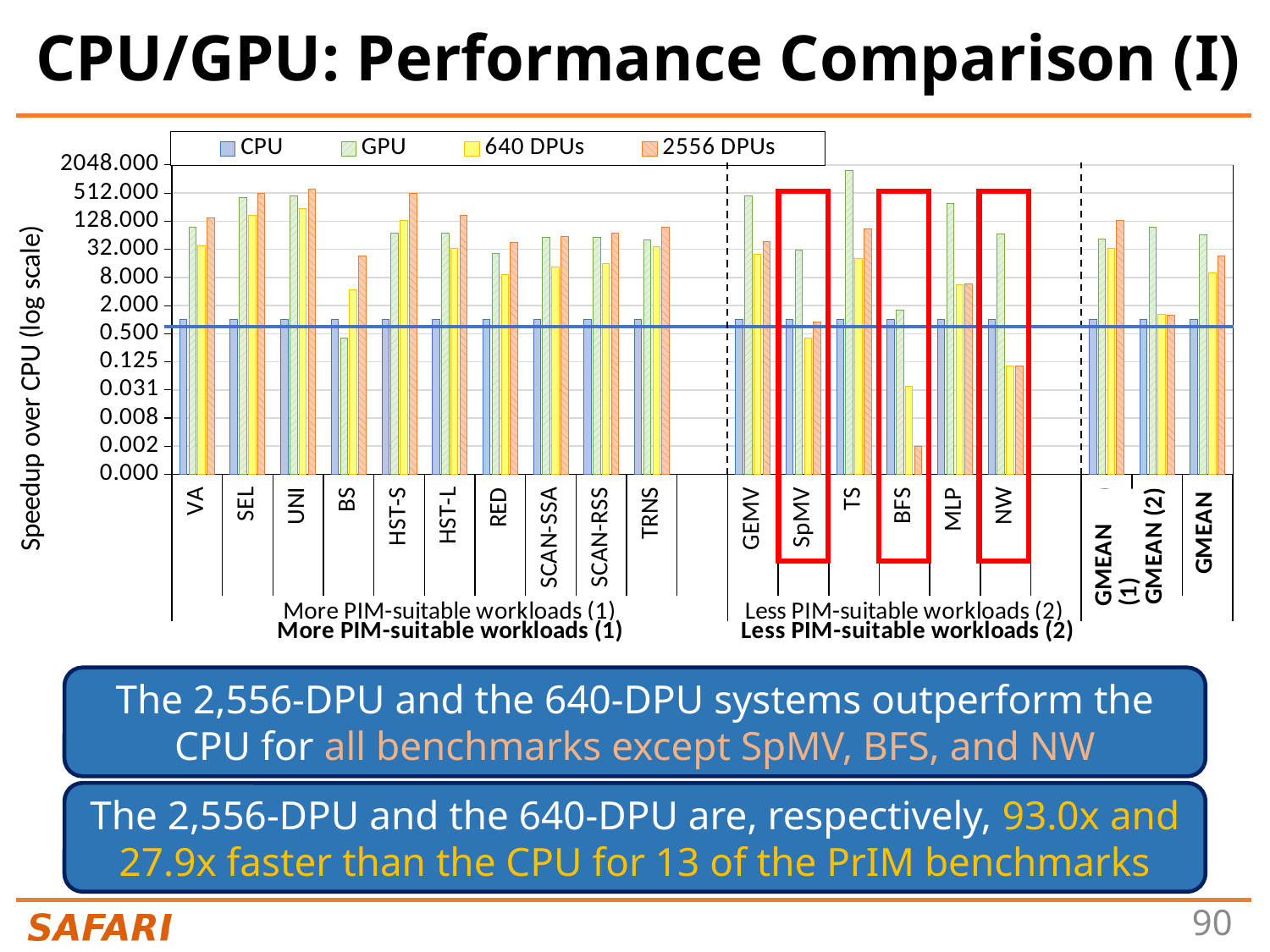
What is the label of the y axis? Speedup over CPU (log scale) How many series does the chart legend list? 4 Is the GPU value for TS greater or less than 512.000? greater Is the 2556 DPUs value for BFS greater or less than 0.008? less Is the 640 DPUs value for NW greater or less than 0.500? less What kind of chart is shown on the slide? bar chart Which benchmark has the lowest 2556 DPUs speedup? BFS Which benchmark has the highest GPU speedup? TS Which three benchmarks are highlighted with red boxes? SpMV, BFS, and NW For BS, which is larger: the GPU speedup or the 2556 DPUs speedup? 2556 DPUs How many benchmark categories (including the GMEAN entries) are shown along the x axis? 19